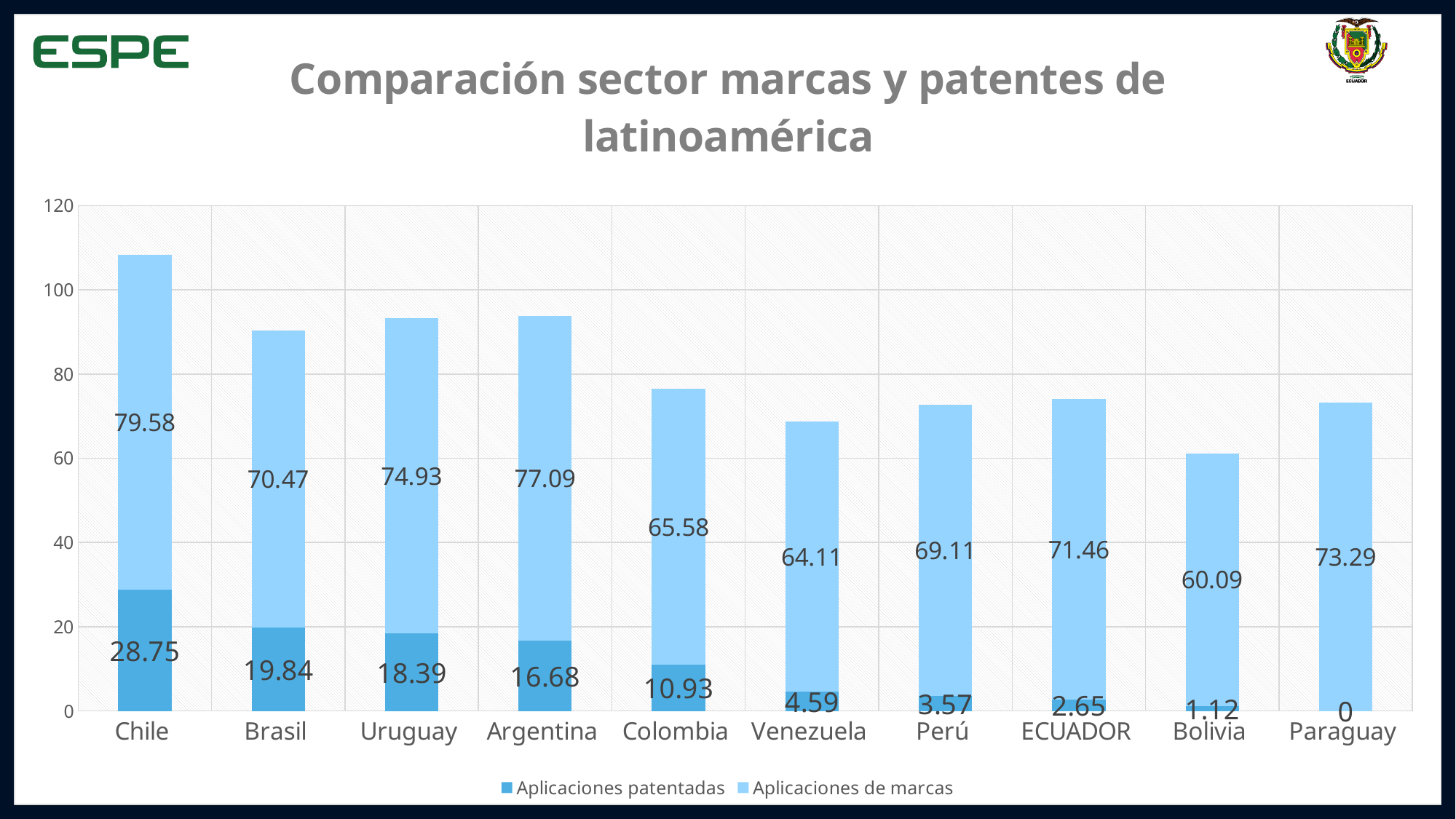
What is the value of Aplicaciones de marcas for ECUADOR? 71.46 What is the value of Aplicaciones patentadas for Chile? 28.75 What is the value of Aplicaciones de marcas for Bolivia? 60.09 Which is larger, the Aplicaciones patentadas value for Uruguay or for Argentina? Uruguay What kind of chart is shown on the slide? Stacked bar chart Do the Aplicaciones patentadas values rise or fall from Chile to Paraguay along the x axis? Fall Which country has the highest value for Aplicaciones patentadas? Chile What is the total of the stacked bar for Chile? 108.33 Which country has the lowest value for Aplicaciones de marcas? Bolivia What is the difference between the Aplicaciones de marcas values for Chile and Brasil? 9.11 How many countries are shown on the x axis? 10 How many series does the legend list? 2